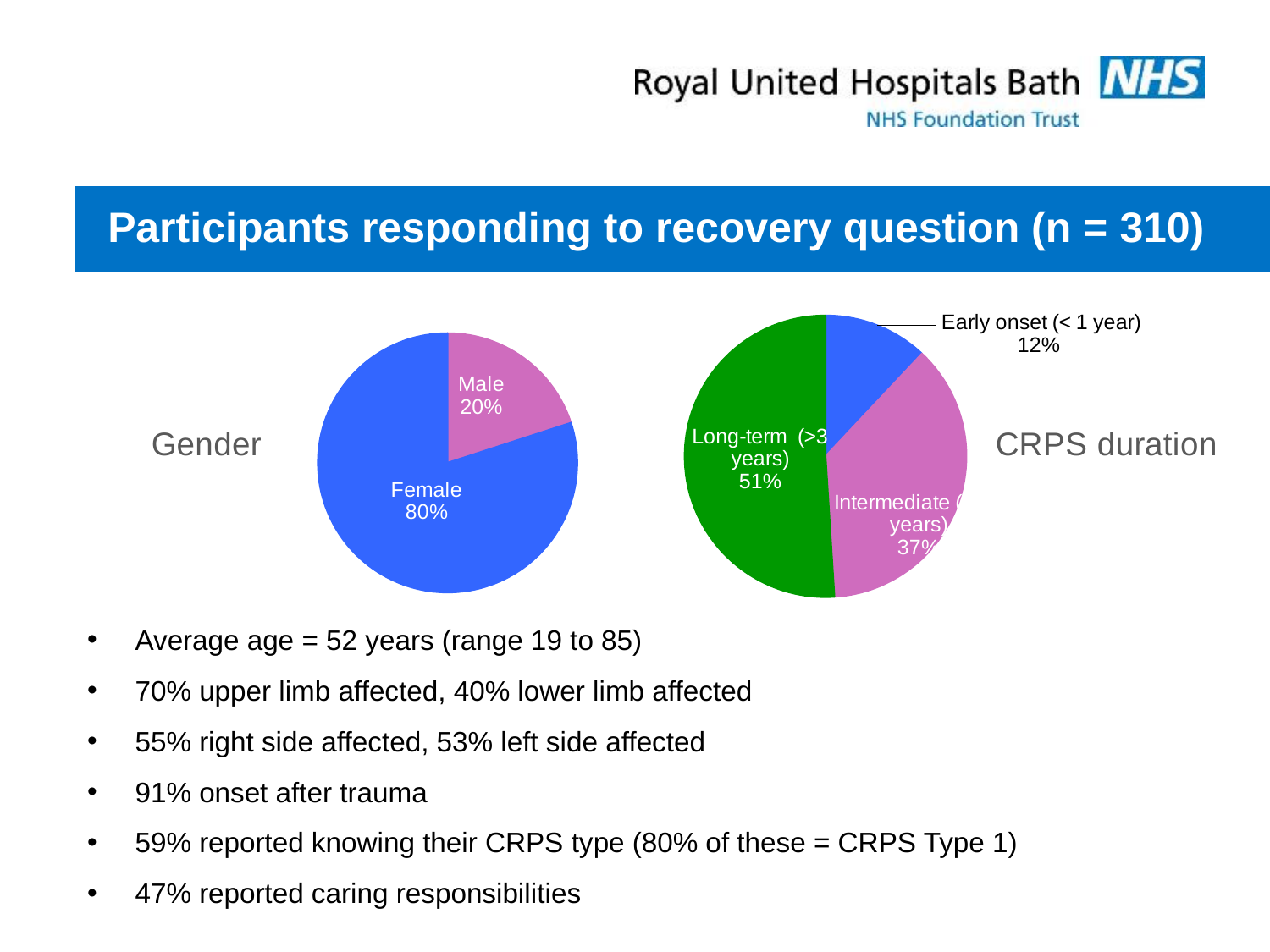
In the CRPS duration pie chart, how many categories are shown? 3 In the CRPS duration pie chart, which category has the largest share? Long-term (>3 years) In the CRPS duration pie chart, what percentage of participants are in the Intermediate category? 37% In the CRPS duration pie chart, what percentage of participants have Long-term (>3 years) CRPS? 51% In the Gender pie chart, what percentage of participants are Female? 80% In the Gender pie chart, what is the difference in percentage points between the Female and Male slices? 60 What type of chart is used to show Gender on this slide? Pie chart In the CRPS duration pie chart, which category has the smallest share? Early onset (< 1 year) In the Gender pie chart, what percentage of participants are Male? 20% In the Gender pie chart, how many slices are there? 2 In the Gender pie chart, which slice is the largest? Female In the CRPS duration pie chart, what percentage of participants have Early onset (< 1 year)? 12%